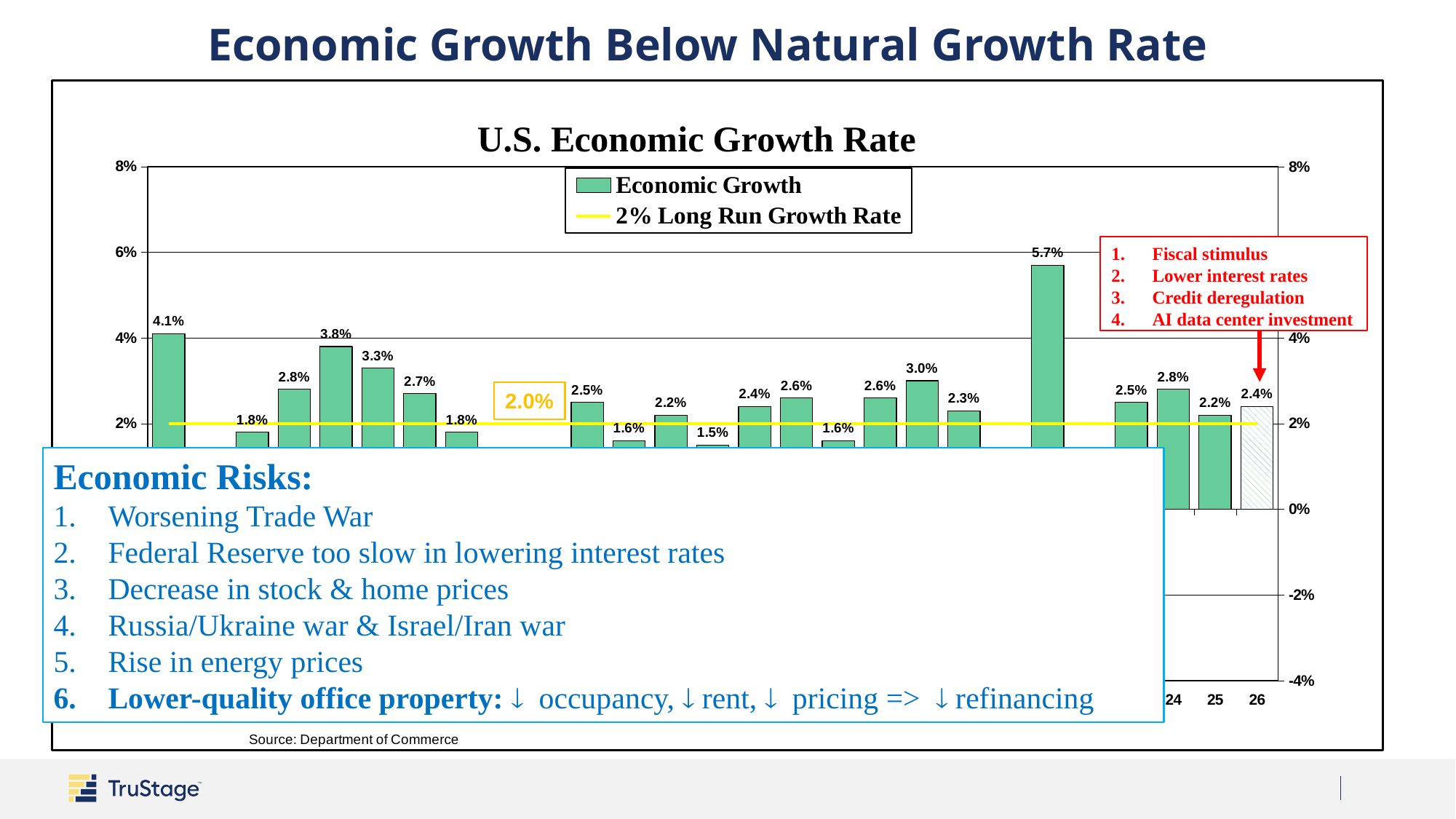
What is the economic growth rate shown for 25? 2.2% Which year has the higher growth rate, 25 or 26? 26 What is the economic growth rate shown for 26? 2.4% What is the title of the chart? U.S. Economic Growth Rate What is the difference between the growth rate for 24 and the growth rate for 25? 0.6% What is the highest economic growth rate labeled on the chart? 5.7% What does the yellow line in the chart represent? 2% Long Run Growth Rate What is the lowest economic growth rate labeled on the chart? 1.5% Is the growth rate for 26 greater or less than the 2% long run growth rate? greater What is the economic growth rate shown for 24? 2.8% What kind of chart is used to show the economic growth data? Bar chart How many series does the legend list? 2